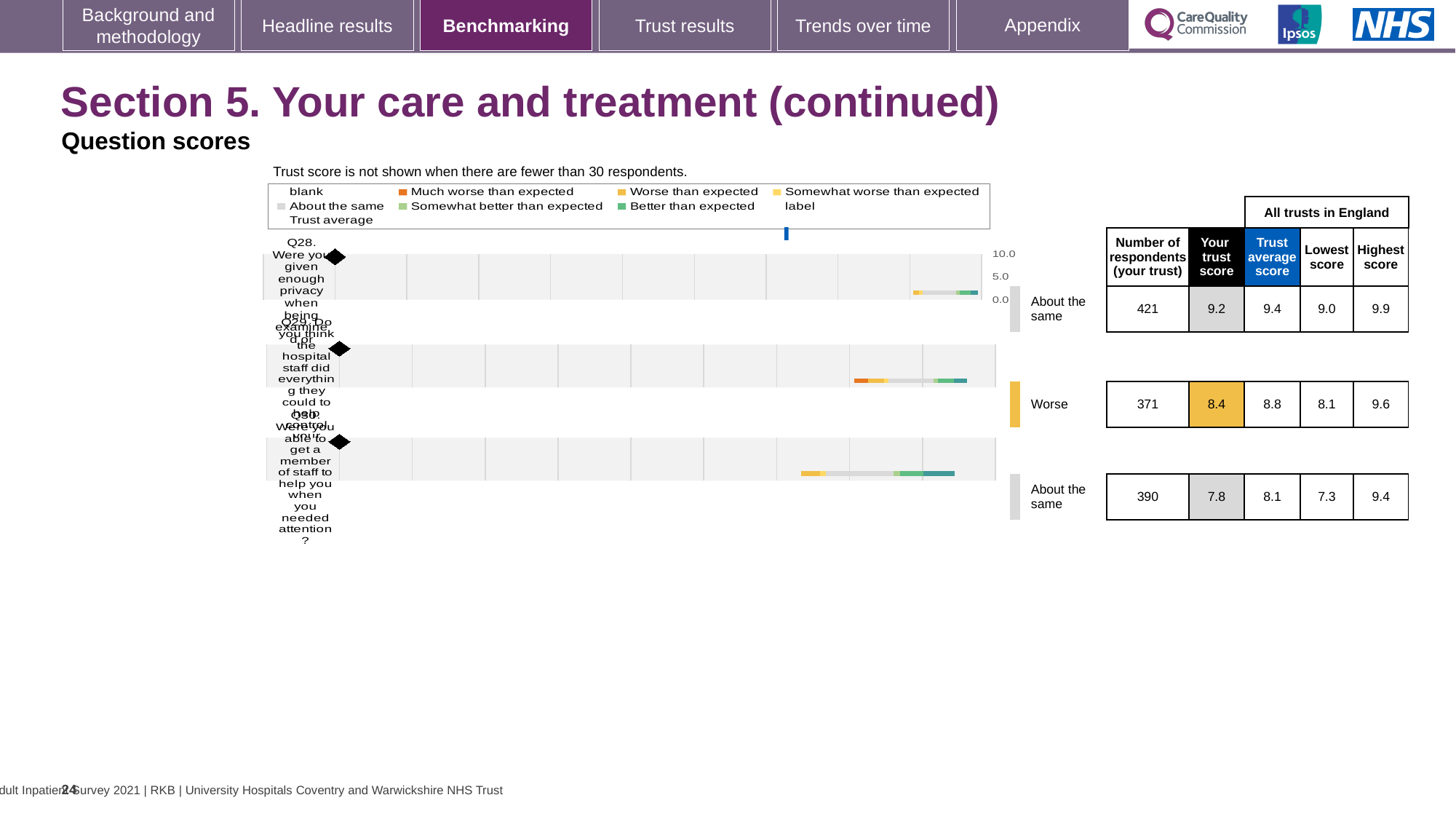
What kind of chart is used to show the question scores on this slide? Bar chart How many questions (Q28, Q29, Q30) are charted on this slide? 3 What is the lowest score across all trusts in England for Q30? 7.3 Which question has the highest trust score on this slide? Q28 Which question on this slide is rated 'Worse' than expected? Q29 What is the trust score for Q28 (Were you given enough privacy when being examined or treated)? 9.2 For Q29, which is larger: the trust score or the trust average score? Trust average score What is the highest score across all trusts in England for Q28? 9.9 What is the difference between the trust score for Q28 and the trust score for Q30? 1.4 How many respondents answered Q29 (Do you think the hospital staff did everything they could to help control your pain)? 371 What is the trust average score for Q30 (Were you able to get a member of staff to help you when you needed attention)? 8.1 Which question has the lowest trust score on this slide? Q30